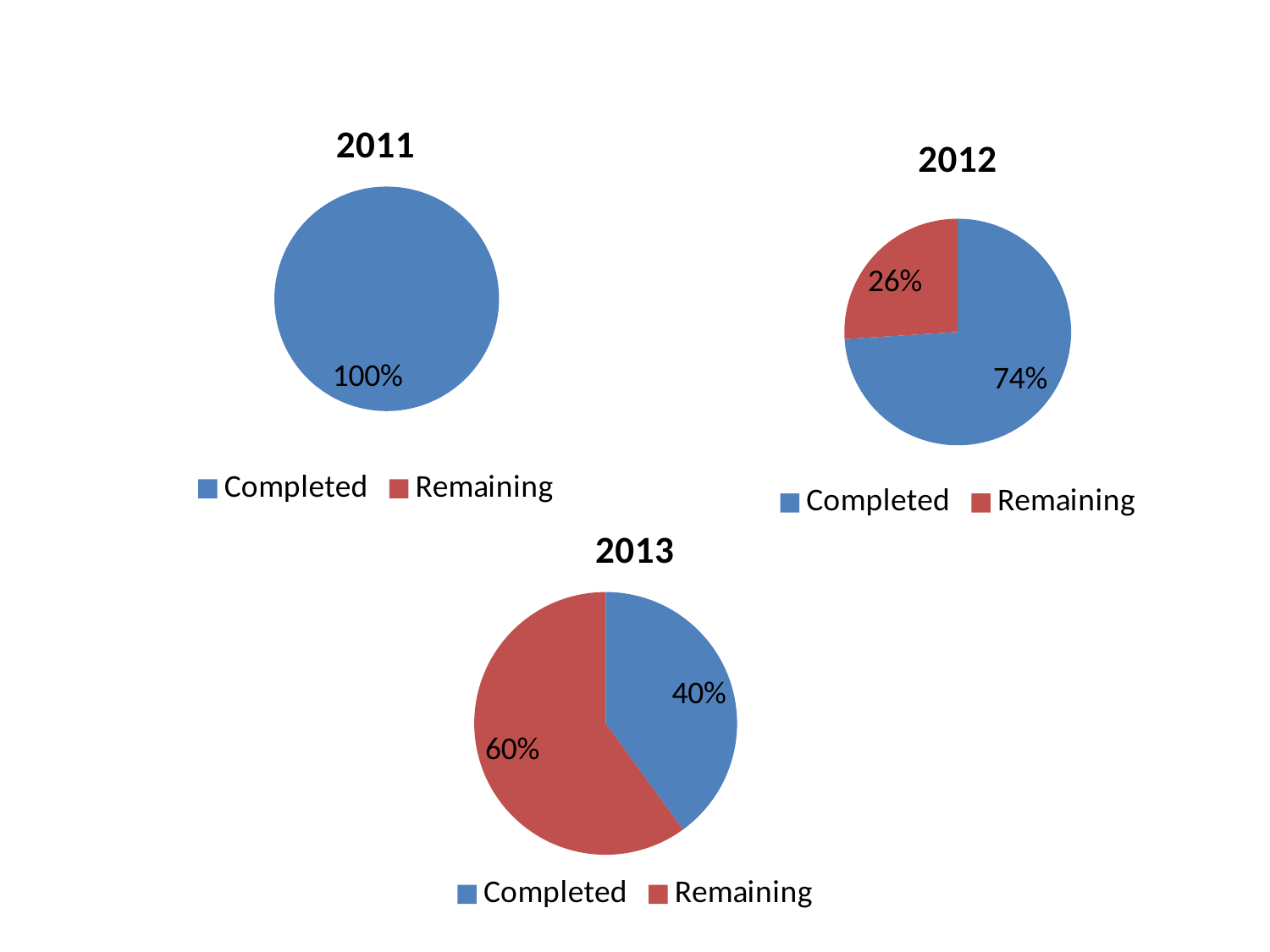
In the 2011 chart, what share of the pie is Completed? 100% In the 2012 chart, which slice is the largest? Completed How many entries does the legend of the 2012 chart list? 2 In the 2012 chart, what share of the pie is Completed? 74% In the 2013 chart, what share of the pie is Remaining? 60% In the 2012 chart, what is the difference between the Completed and Remaining shares? 48% In the 2013 chart, which slice is larger, Completed or Remaining? Remaining In the 2013 chart, what is the difference between the Remaining and Completed shares? 20% What is the title of the chart at the bottom of the slide? 2013 What kind of chart is the 2013 chart? Pie chart